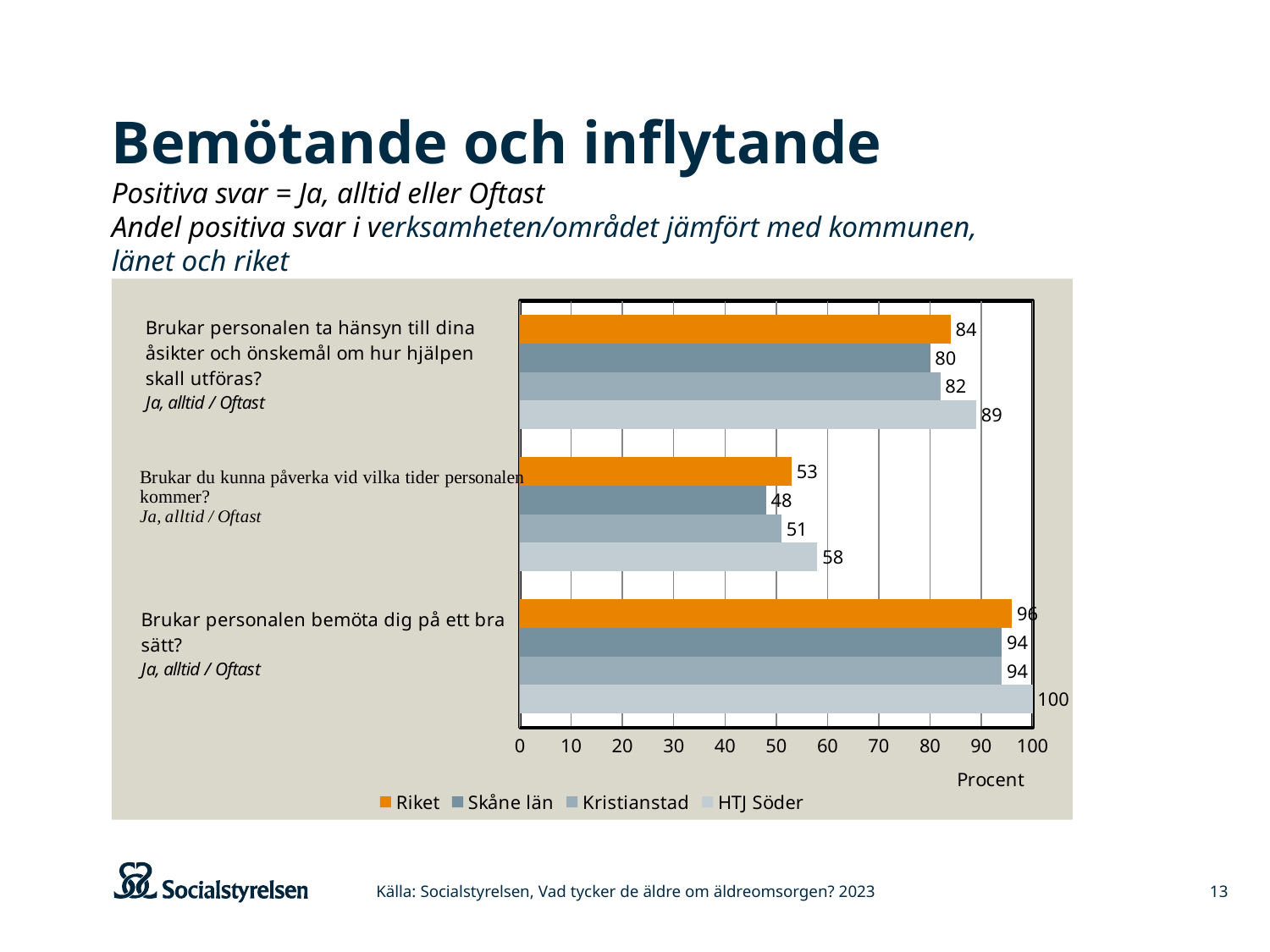
Which series has the lowest value on the question "Brukar personalen ta hänsyn till dina åsikter och önskemål om hur hjälpen skall utföras?"? Skåne län What is the value for HTJ Söder on the question "Brukar personalen bemöta dig på ett bra sätt?"? 100 What is the difference between HTJ Söder and Riket on the question "Brukar personalen ta hänsyn till dina åsikter och önskemål om hur hjälpen skall utföras?"? 5 Which is larger on the question "Brukar personalen bemöta dig på ett bra sätt?": Riket or Skåne län? Riket Which series has the highest value on the question "Brukar du kunna påverka vid vilka tider personalen kommer?"? HTJ Söder What is the difference between HTJ Söder and Skåne län on the question "Brukar du kunna påverka vid vilka tider personalen kommer?"? 10 What kind of chart is shown on the slide? Bar chart What is the value for Kristianstad on the question "Brukar du kunna påverka vid vilka tider personalen kommer?"? 51 What is the value for Skåne län on the question "Brukar personalen ta hänsyn till dina åsikter och önskemål om hur hjälpen skall utföras?"? 80 How many series does the legend list? 4 How many question categories are shown on the chart? 3 What is the value for Riket on the question "Brukar du kunna påverka vid vilka tider personalen kommer?"? 53